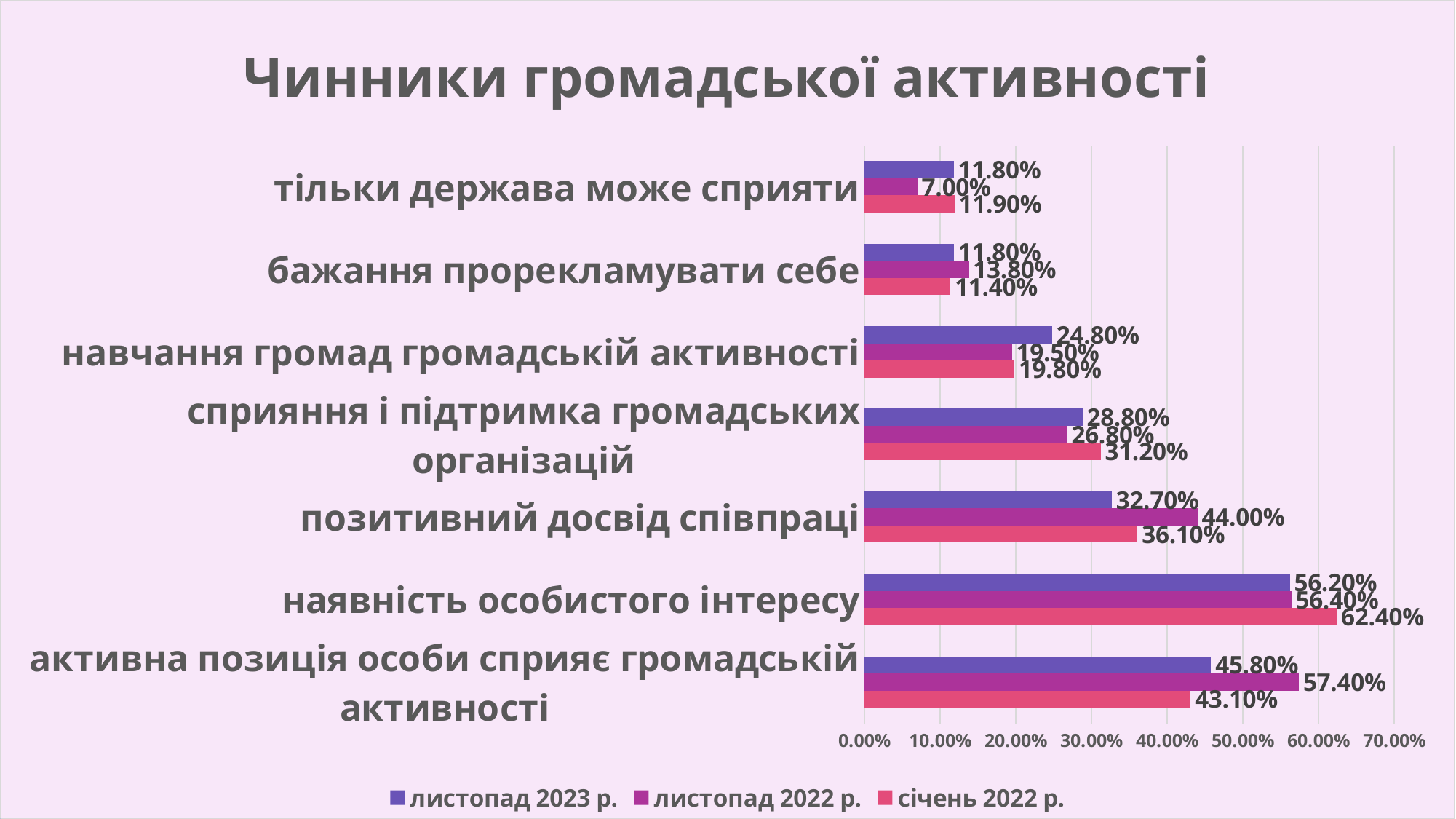
What is the value for 'активна позиція особи сприяє громадській активності' in the 'листопад 2023 р.' series? 45.80% What is the title of the chart? Чинники громадської активності Which category has the lowest value in the 'листопад 2022 р.' series? тільки держава може сприяти For 'сприяння і підтримка громадських організацій', which series has the larger value: 'листопад 2023 р.' or 'січень 2022 р.'? січень 2022 р. What is the value for 'тільки держава може сприяти' in the 'листопад 2022 р.' series? 7.00% What type of chart is shown on the slide? bar chart How many categories are shown on the chart? 7 How many series does the legend list? 3 What is the difference between the 'листопад 2022 р.' and 'листопад 2023 р.' values for 'позитивний досвід співпраці'? 11.30% Which category has the highest value in the 'листопад 2022 р.' series? активна позиція особи сприяє громадській активності Is the 'січень 2022 р.' value for 'наявність особистого інтересу' greater or less than 60.00%? greater What is the value for 'наявність особистого інтересу' in the 'січень 2022 р.' series? 62.40%